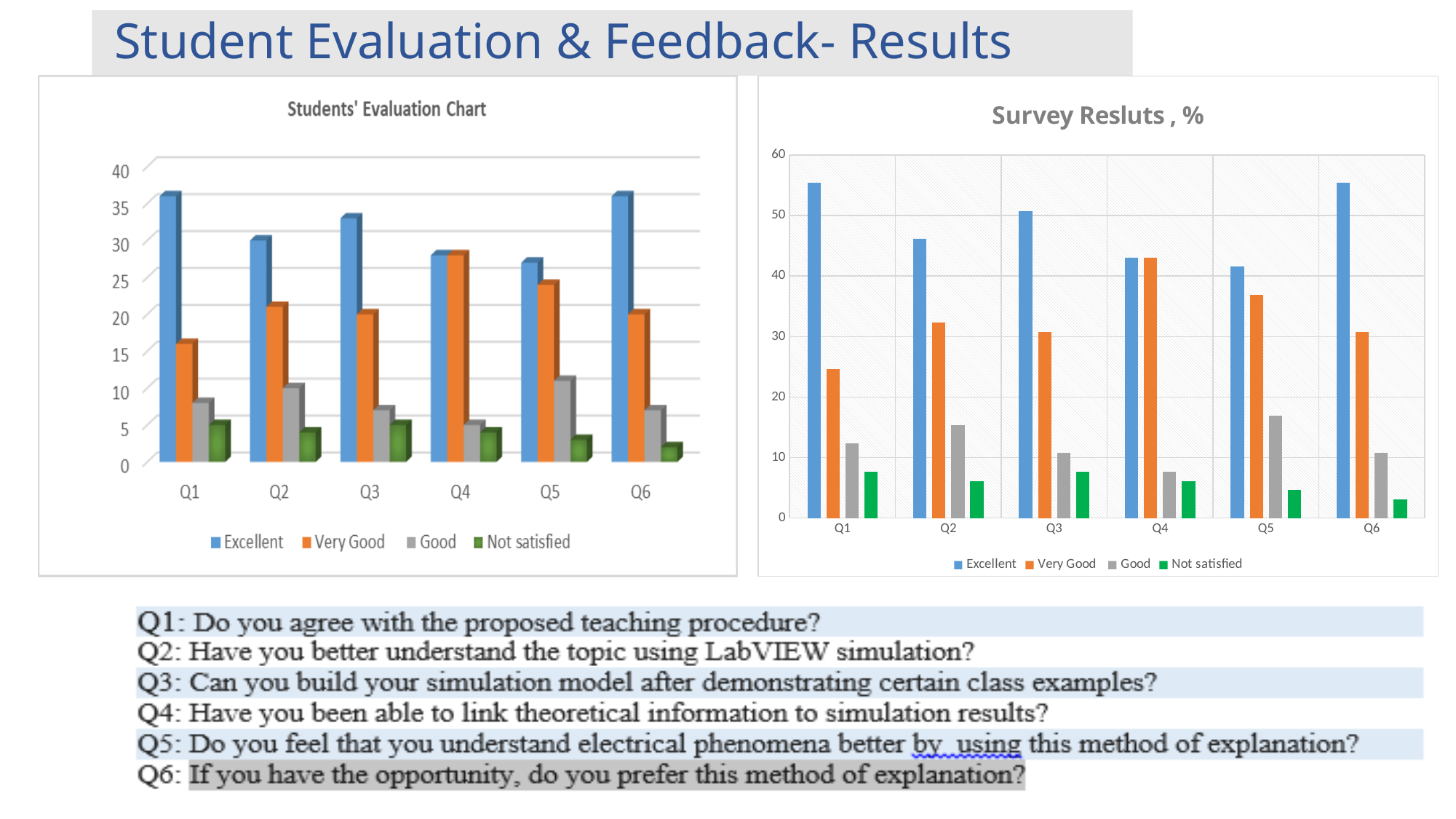
In the 'Students' Evaluation Chart', which is larger for Q1: the 'Excellent' value or the 'Very Good' value? Excellent In the 'Survey Resluts , %' chart, which series is shown in green? Not satisfied In the 'Survey Resluts , %' chart, which question has the highest 'Very Good' value? Q4 What kind of chart is the 'Survey Resluts , %' chart on the right? bar chart How many series does the legend of the 'Students' Evaluation Chart' list? 4 In the 'Survey Resluts , %' chart, is the 'Very Good' value for Q5 greater or less than 30? greater In the 'Survey Resluts , %' chart, which question has the lowest 'Very Good' value? Q1 In the 'Students' Evaluation Chart', is the 'Excellent' value for Q3 greater or less than 30? greater In the 'Survey Resluts , %' chart, is the 'Excellent' value for Q2 greater or less than 40? greater In the 'Students' Evaluation Chart', which question has the lowest 'Not satisfied' value? Q6 How many question categories are shown on the x axis of the 'Survey Resluts , %' chart? 6 In the 'Students' Evaluation Chart', which question has the highest 'Good' value? Q5